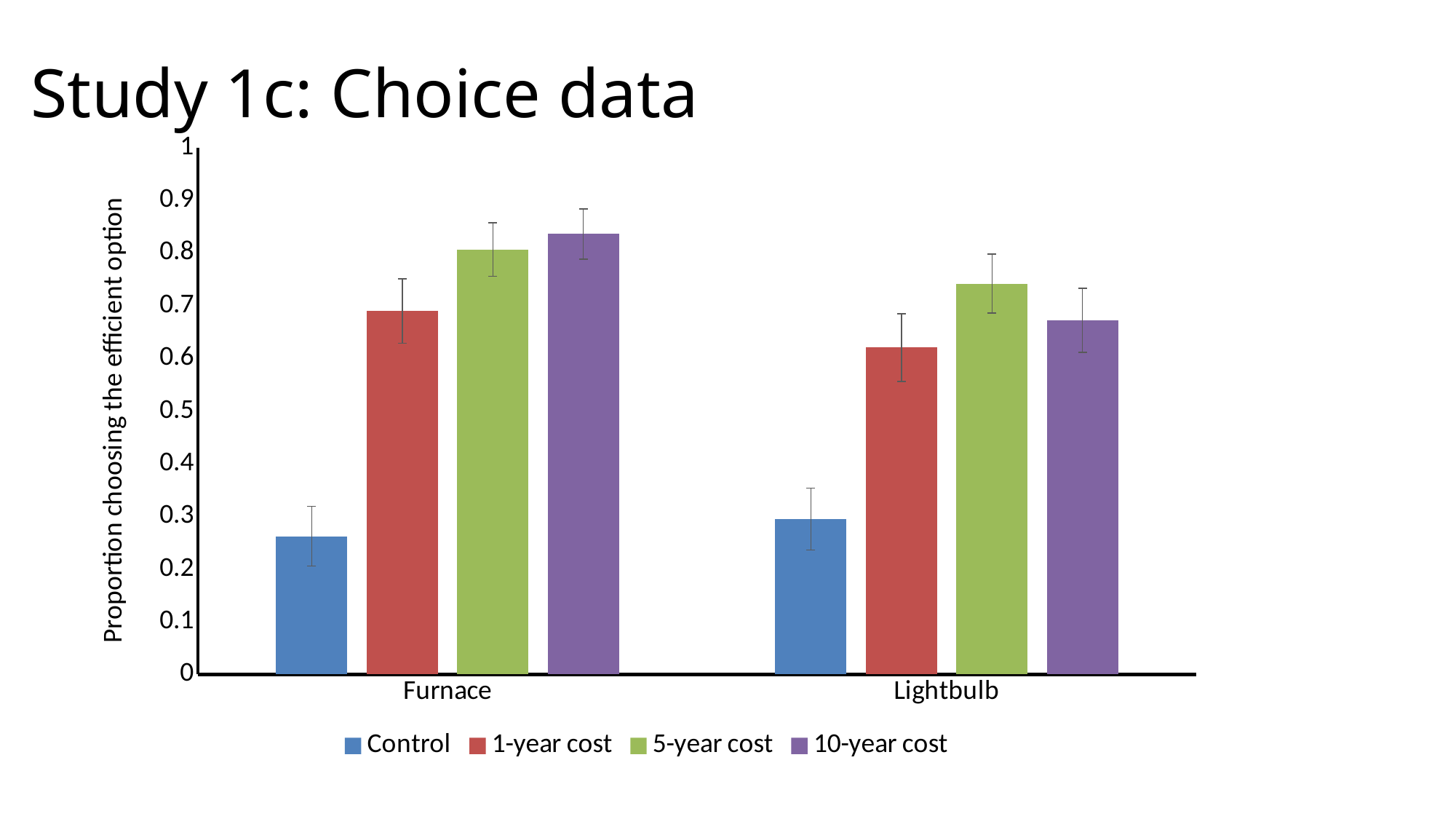
Is the 10-year cost value for Lightbulb greater or less than 0.7? less Is the Control value for Furnace greater or less than 0.3? less Which series has the highest value for Lightbulb? 5-year cost Is the 1-year cost value for Lightbulb greater or less than 0.5? greater What kind of chart is shown on the slide? bar chart Which series has the lowest value for Lightbulb? Control How many categories are shown on the x axis? 2 Which series has the lowest value for Furnace? Control Which is larger: the 1-year cost value for Furnace or the 1-year cost value for Lightbulb? Furnace How many series does the legend list? 4 What is the label on the y axis? Proportion choosing the efficient option